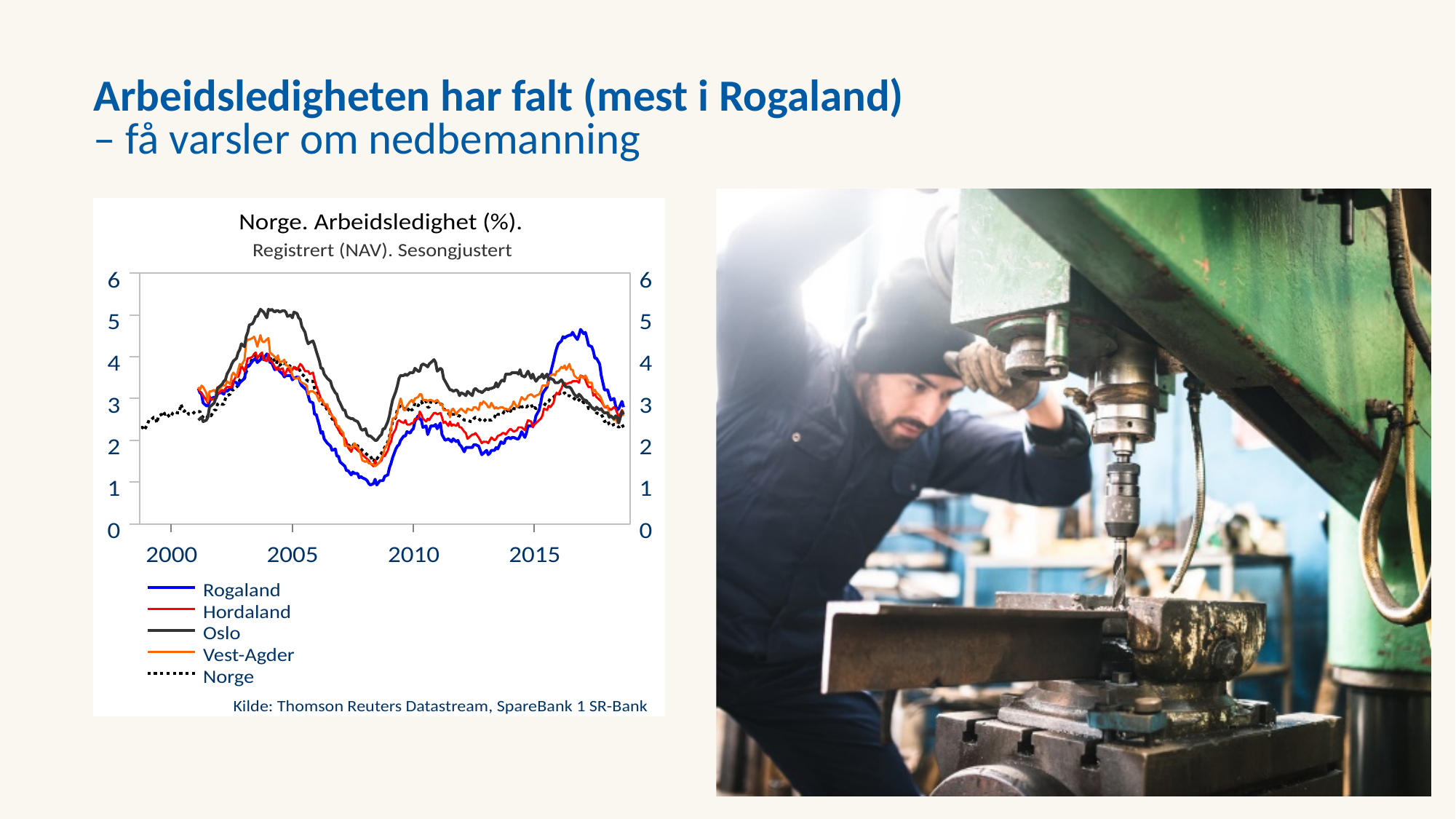
Which series reaches the highest value anywhere on the chart? Oslo Which series is drawn as a dotted black line in the chart? Norge Does the Rogaland series rise or fall from its 2017 peak to the end of the chart? Fall Which series reaches the lowest value anywhere on the chart? Rogaland Is the value for Rogaland around 2013 greater or less than 2? less Around 2004, which series is higher: Oslo or Rogaland? Oslo What is the title of the chart? Norge. Arbeidsledighet (%). How many series does the legend of the chart list? 5 Is the value for Oslo around 2008 greater or less than 3? less Around 2017, which series is higher: Rogaland or Oslo? Rogaland Is the peak value for Rogaland around 2016-2017 greater or less than 4? greater What kind of chart is shown on the slide? Line chart